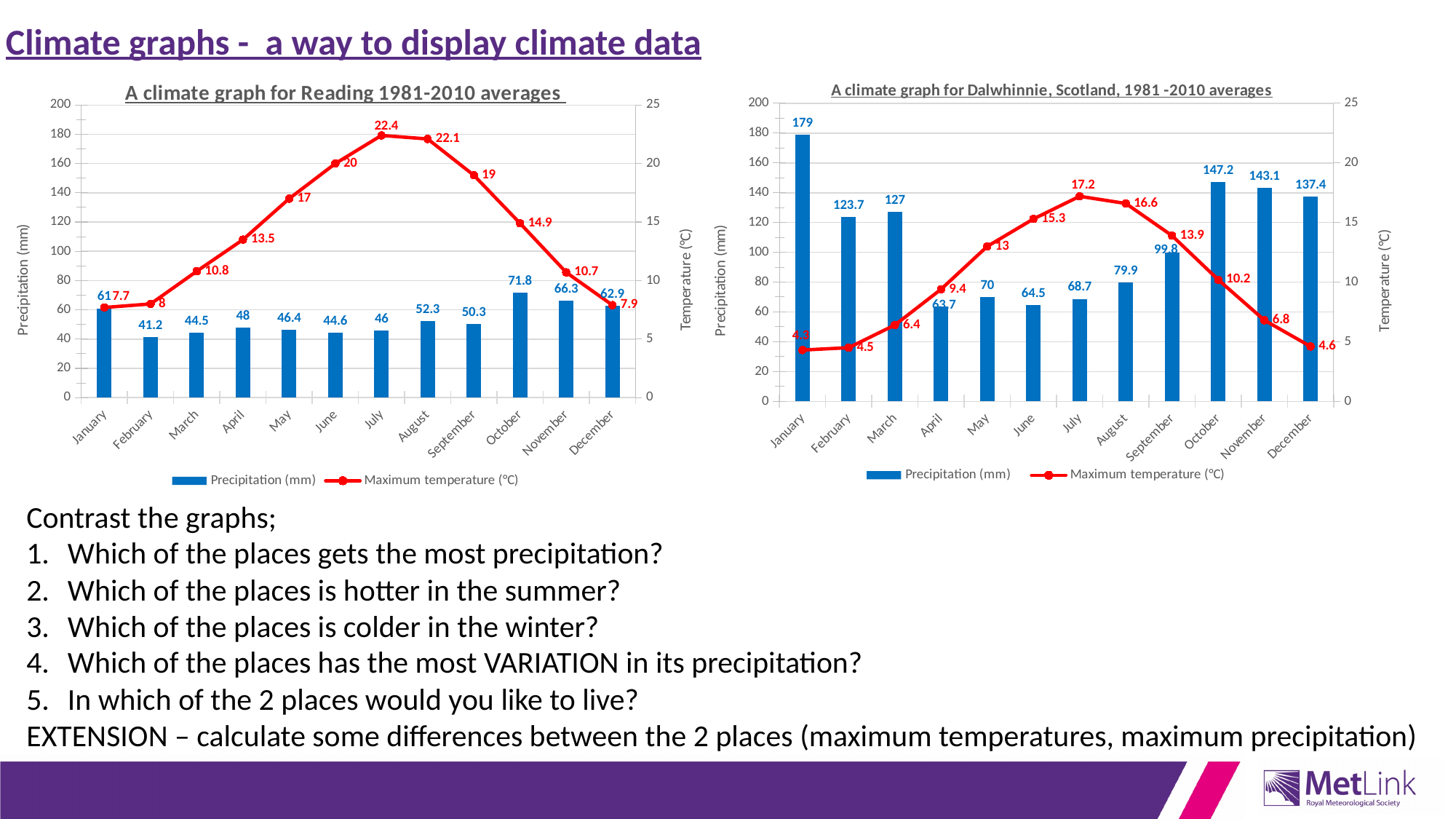
How many series does the legend of the climate graph for Dalwhinnie list? 2 In the climate graph for Dalwhinnie, which month has the highest precipitation? January In the climate graph for Dalwhinnie, which month has the highest maximum temperature? July In the climate graph for Reading, which month has the lowest precipitation? February In the climate graph for Dalwhinnie, what is the precipitation for October? 147.2 In the climate graph for Dalwhinnie, what is the maximum temperature for August? 16.6 In the climate graph for Reading, what is the maximum temperature for July? 22.4 How many months are shown on the x axis of the climate graph for Reading? 12 In the climate graph for Reading, what is the precipitation for October? 71.8 In the climate graph for Reading, is the precipitation for August greater or less than the precipitation for September? greater In the climate graph for Dalwhinnie, what is the difference in precipitation between January and April? 115.3 In the climate graph for Reading, does the maximum temperature rise or fall from January to July? rise